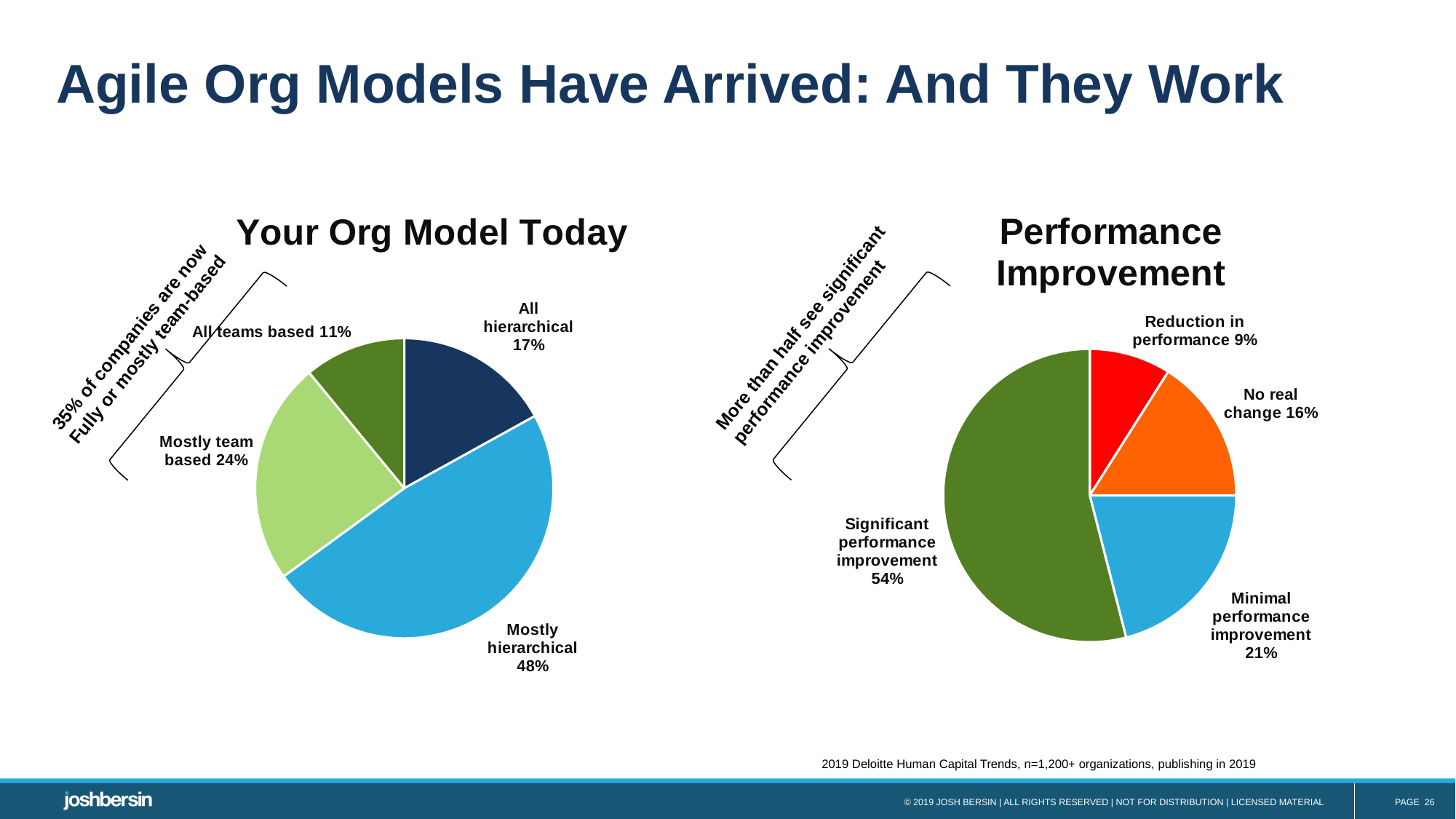
In the 'Performance Improvement' chart, what is the difference between 'Significant performance improvement' and 'Minimal performance improvement'? 33% In the 'Your Org Model Today' chart, what share is 'Mostly hierarchical'? 48% In the 'Your Org Model Today' chart, how many categories are shown? 4 In the 'Performance Improvement' chart, what share is 'Significant performance improvement'? 54% In the 'Performance Improvement' chart, which is larger: 'Minimal performance improvement' or 'No real change'? Minimal performance improvement In the 'Performance Improvement' chart, which category has the smallest slice? Reduction in performance In the 'Your Org Model Today' chart, what share is 'All teams based'? 11% In the 'Your Org Model Today' chart, what is the difference between 'Mostly team based' and 'All hierarchical'? 7% In the 'Your Org Model Today' chart, which category has the largest slice? Mostly hierarchical In the 'Your Org Model Today' chart, which category has the smallest slice? All teams based In the 'Performance Improvement' chart, what share is 'Reduction in performance'? 9% What type of chart is the 'Performance Improvement' chart? Pie chart